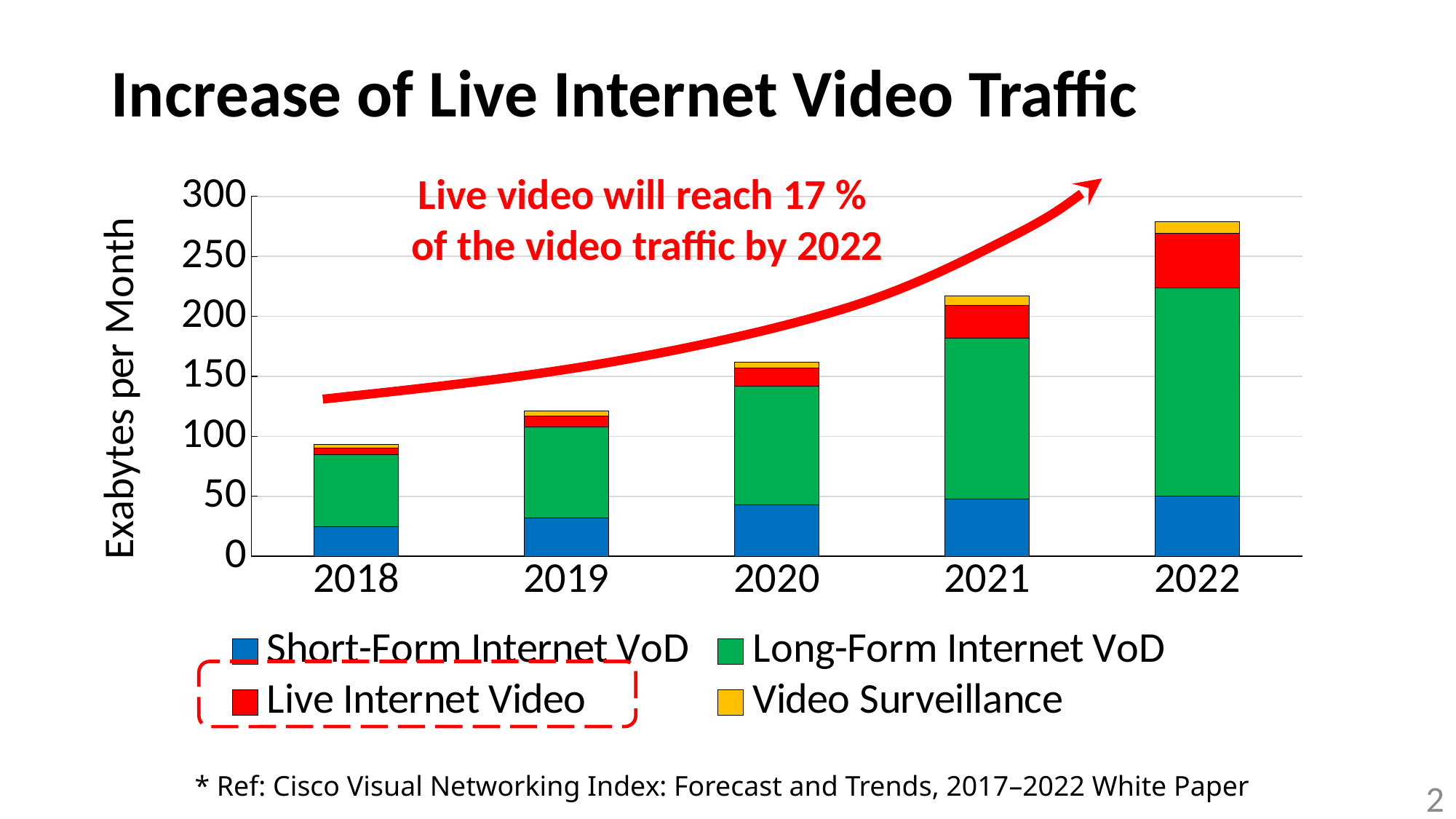
Which year has the larger total bar, 2020 or 2021? 2021 Do the total bar heights rise or fall from 2018 to 2022? rise Is the total bar for 2018 greater or less than 100 exabytes per month? less Which year has the highest total bar in the chart? 2022 How many years are shown on the x axis of the chart? 5 What kind of chart is shown on the slide? stacked bar chart What is the label on the y axis of the chart? Exabytes per Month How many series does the chart's legend list? 4 Which colour represents Live Internet Video in the chart's legend? red Is the total bar for 2021 greater or less than 200 exabytes per month? greater Which year has the lowest total bar in the chart? 2018 Is the total bar for 2022 greater or less than 250 exabytes per month? greater